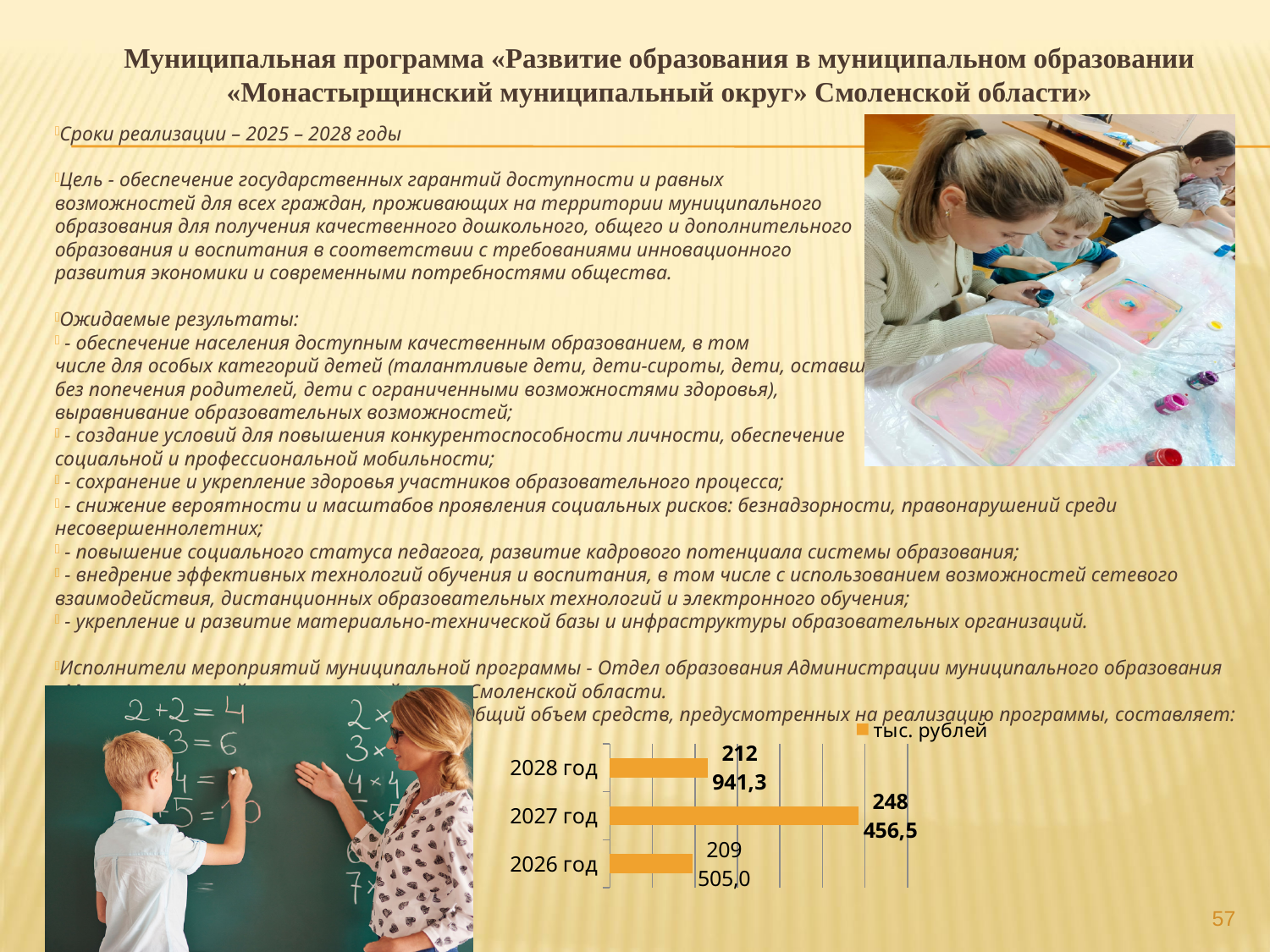
What is the difference between the values for 2027 год and 2026 год in the chart? 38 951,5 What is the value for 2027 год in the chart? 248 456,5 How many series does the chart legend list? 1 What is the value for 2026 год in the chart? 209 505,0 Which year has the highest value in the chart? 2027 год Which is larger in the chart: the value for 2027 год or the value for 2028 год? 2027 год What is the legend entry of the chart? тыс. рублей What is the value for 2028 год in the chart? 212 941,3 What kind of chart is shown at the bottom of the slide? bar chart What is the difference between the values for 2028 год and 2026 год in the chart? 3 436,3 Which year has the lowest value in the chart? 2026 год How many years (categories) are shown in the chart? 3